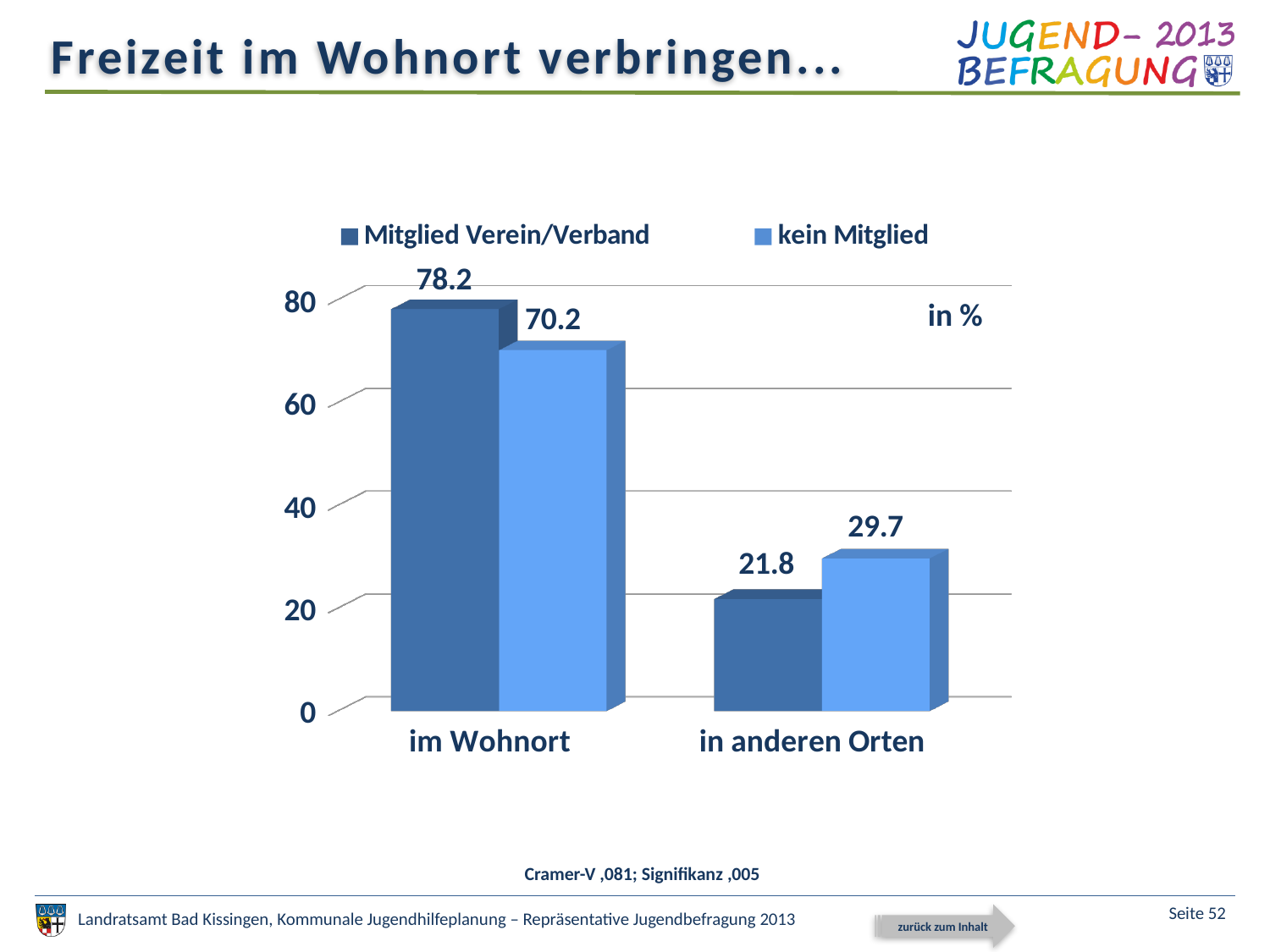
Which category has the lowest value for the kein Mitglied series? in anderen Orten What is the value for kein Mitglied in the category in anderen Orten? 29.7 Which category has the highest value for the Mitglied Verein/Verband series? im Wohnort How many series does the legend list? 2 What is the difference between kein Mitglied and Mitglied Verein/Verband in the category in anderen Orten? 7.9 What kind of chart is shown on the slide? bar chart What is the value for kein Mitglied in the category im Wohnort? 70.2 What is the value for Mitglied Verein/Verband in the category in anderen Orten? 21.8 What is the difference between Mitglied Verein/Verband and kein Mitglied in the category im Wohnort? 8.0 What is the value for Mitglied Verein/Verband in the category im Wohnort? 78.2 How many categories are shown on the x axis? 2 In the category in anderen Orten, which series has the larger value: Mitglied Verein/Verband or kein Mitglied? kein Mitglied